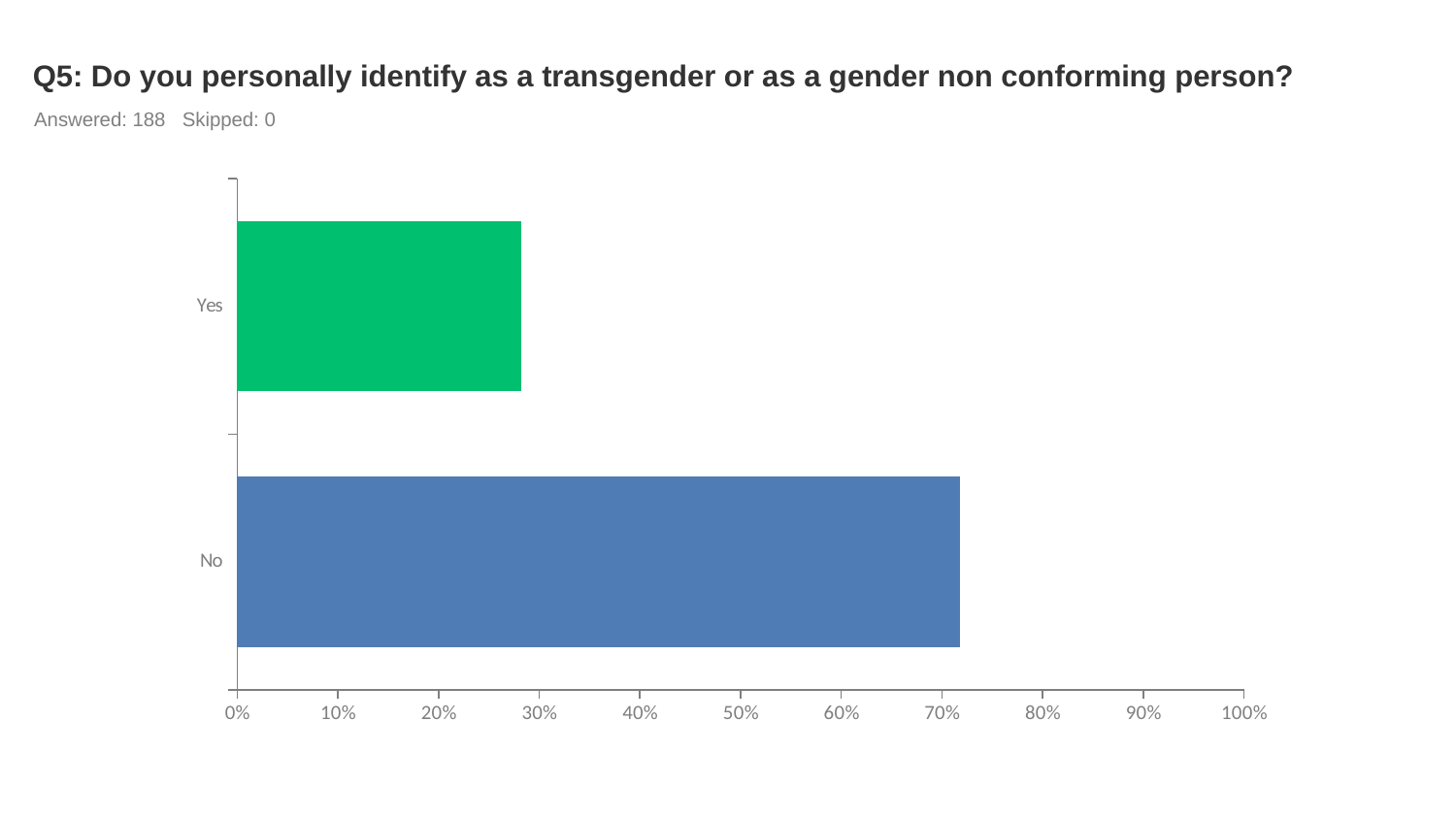
What is the maximum value shown on the x axis? 100% How many categories are plotted in the chart? 2 Which category has the highest value? No Is the value for No greater or less than 80%? less Is the value for No greater or less than 60%? greater Is the value for Yes greater or less than 30%? less What kind of chart is shown on the slide? bar chart Which category has the lowest value? Yes Which is larger, the value for Yes or the value for No? No What is the title of the chart? Q5: Do you personally identify as a transgender or as a gender non conforming person? How many respondents answered the question according to the slide? 188